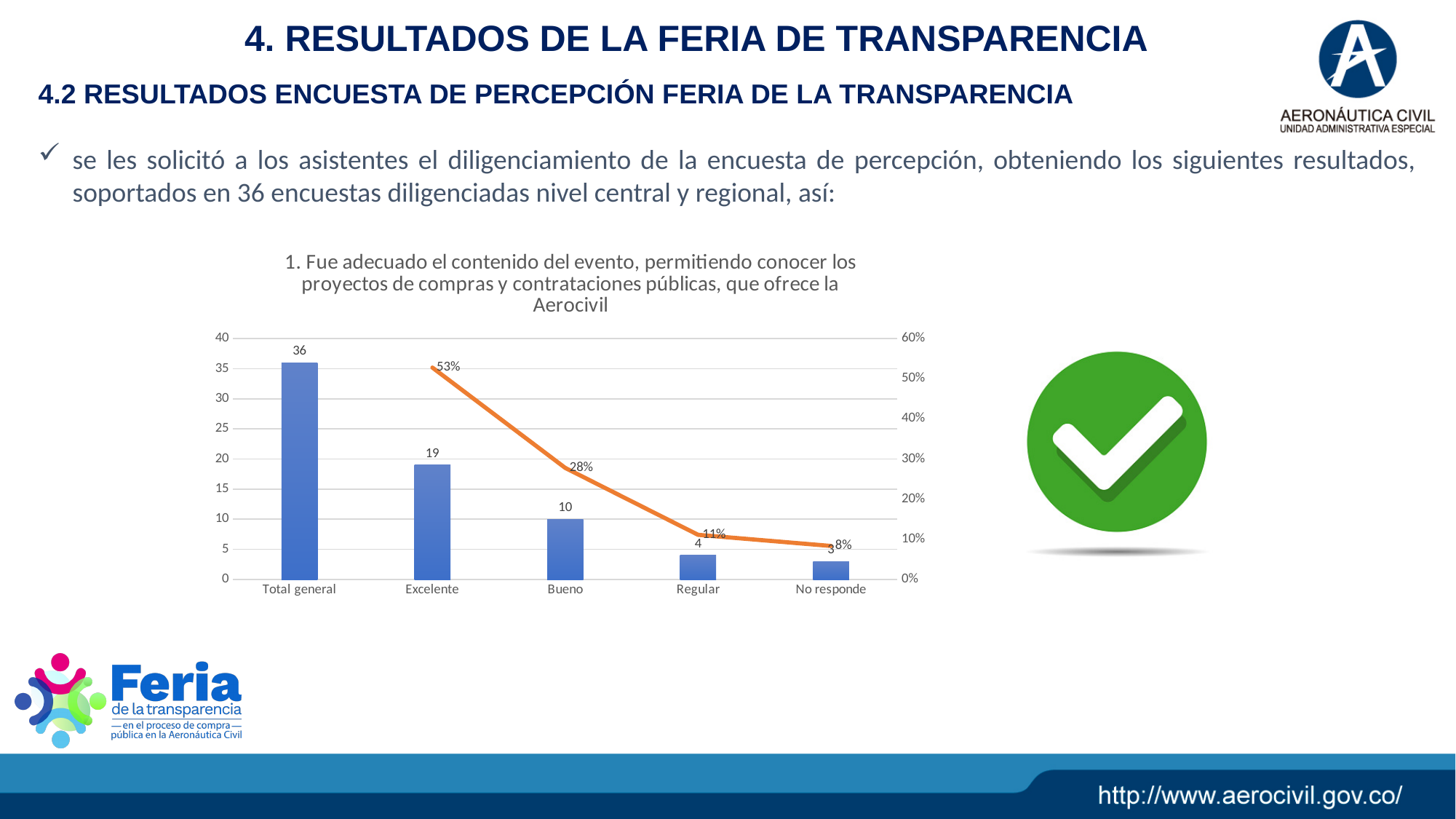
What percentage is shown on the line for Excelente? 53% What is the value of the Regular bar? 4 What is the difference between the Excelente and Bueno bar values? 9 Which category has the tallest bar? Total general How many respondents answered Excelente? 19 What percentage is shown on the line for Bueno? 28% What is the value of the No responde bar? 3 What is the value of the Bueno bar? 10 Does the percentage line rise or fall from Excelente to No responde? fall Which category has the shortest bar? No responde What is the value of the Total general bar? 36 How many categories are shown on the x axis? 5